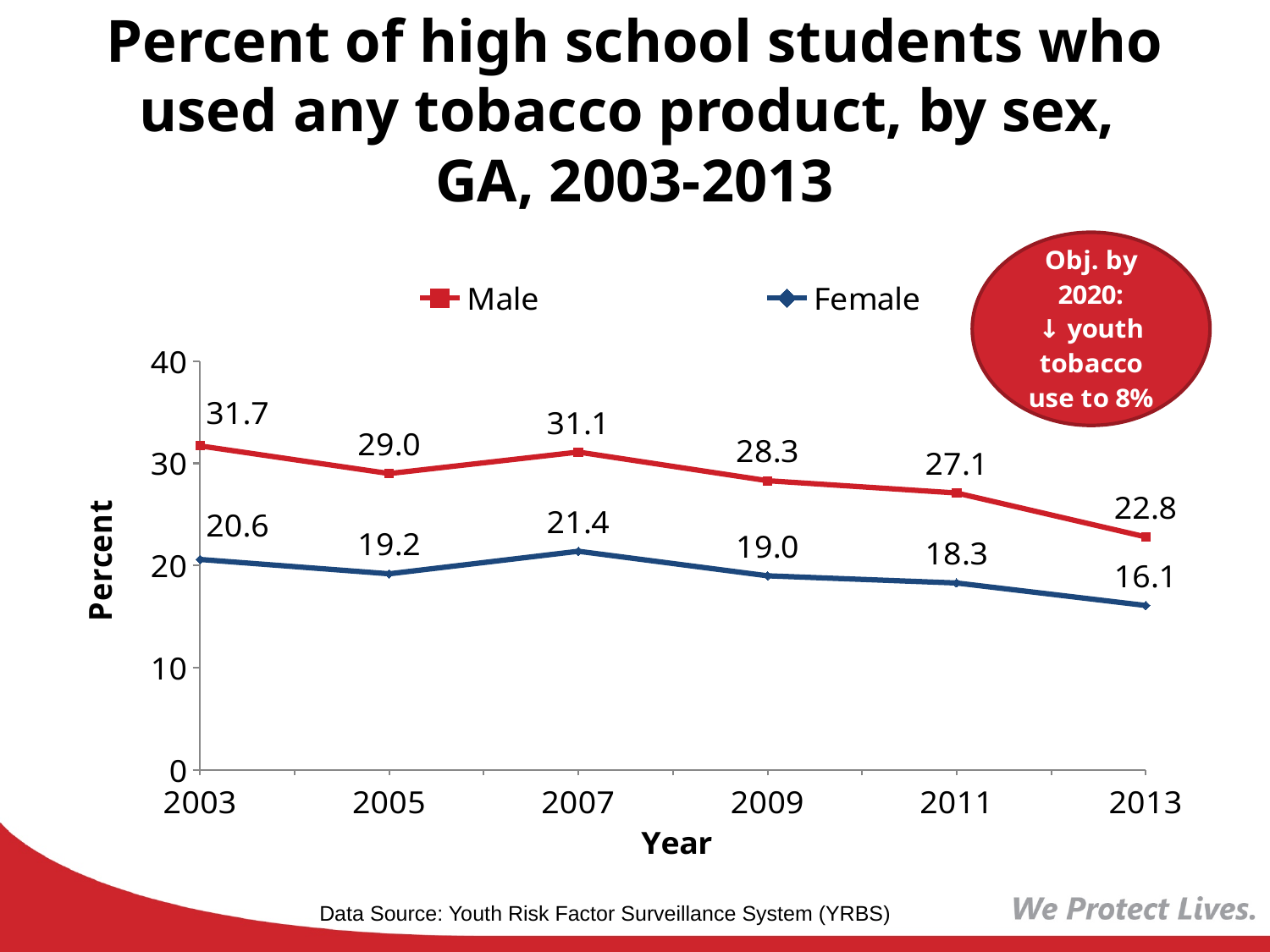
How many series does the legend list? 2 What was the percent of male high school students who used any tobacco product in 2003? 31.7 What was the value for Female in 2007? 21.4 What is the difference between the Male and Female values in 2013? 6.7 In which year was the Female series at its lowest? 2013 How many years are plotted on the x axis? 6 Which series had the higher value in 2009, Male or Female? Male In which year was the Male series at its highest? 2003 What was the percent of female high school students who used any tobacco product in 2013? 16.1 What kind of chart is shown on the slide? Line chart By how much did the Male value decrease from 2003 to 2013? 8.9 Overall, do the Female values rise or fall from 2003 to 2013? Fall